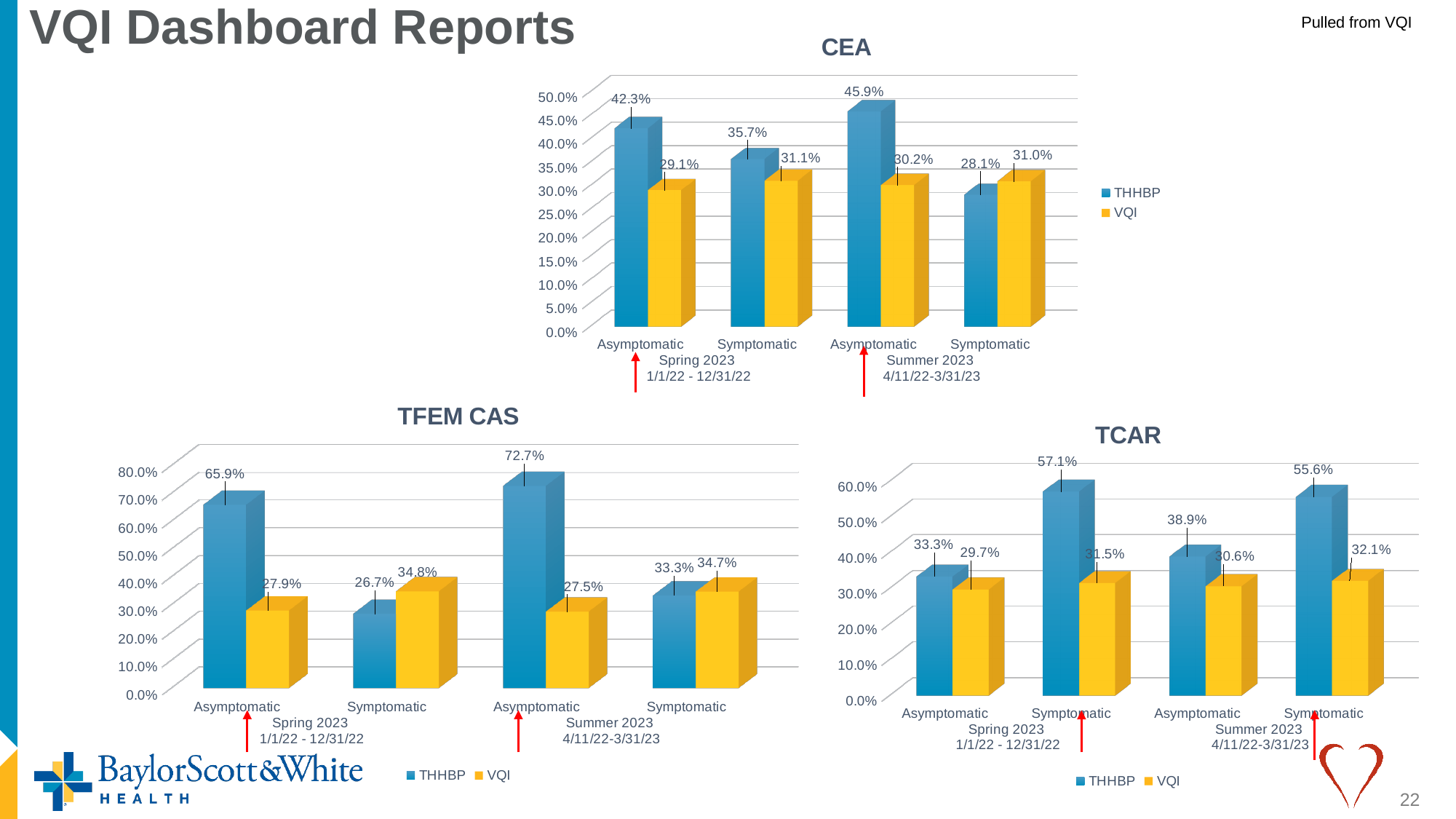
In the TFEM CAS chart, what is the THHBP value for Asymptomatic in Summer 2023? 72.7% In the TCAR chart, which category has the highest VQI value? Symptomatic, Summer 2023 In the CEA chart, what is the difference between the THHBP and VQI values for Asymptomatic in Spring 2023? 13.2% In the TFEM CAS chart, what is the difference between the THHBP and VQI values for Asymptomatic in Summer 2023? 45.2% In the CEA chart, what is the VQI value for Symptomatic in Spring 2023? 31.1% In the CEA chart, which category has the lowest THHBP value? Symptomatic, Summer 2023 How many series does the legend of the TCAR chart list? 2 In the TCAR chart, what is the VQI value for Asymptomatic in Summer 2023? 30.6% In the TFEM CAS chart, which is larger for Symptomatic in Spring 2023, THHBP or VQI? VQI What type of chart is the TFEM CAS chart? Bar chart In the CEA chart, what is the THHBP value for Asymptomatic in Summer 2023? 45.9% In the TCAR chart, what is the THHBP value for Symptomatic in Spring 2023? 57.1%